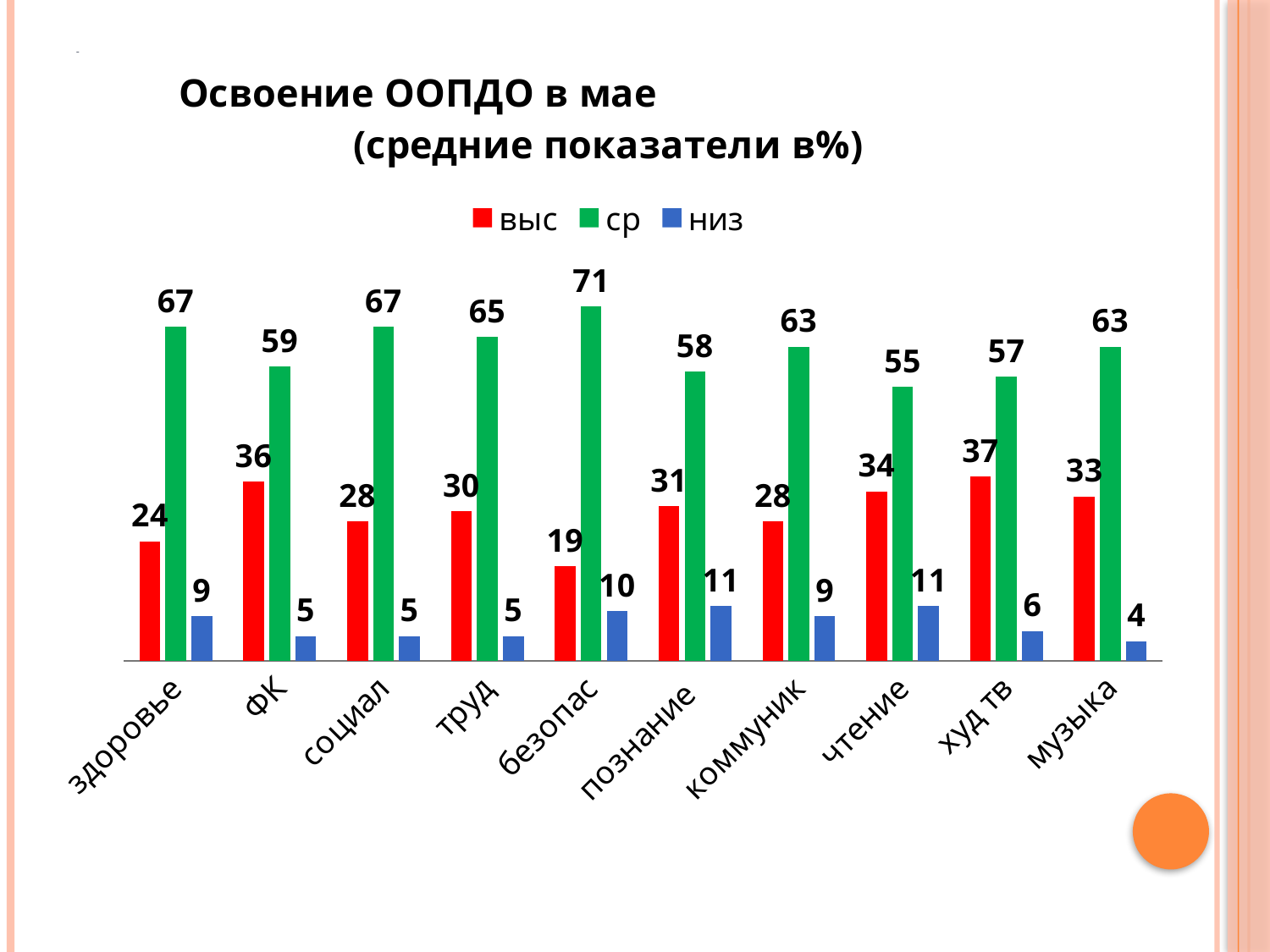
Which category has the highest value in the "ср" series? безопас How many categories are shown on the x axis? 10 What kind of chart is shown on the slide? bar chart Which category has the lowest value in the "низ" series? музыка What is the value of the "низ" series for "познание"? 11 Which colour represents the "ср" series in the legend? green What is the difference between the "ср" and "выс" values for "ФК"? 23 What is the value of the "ср" series for "безопас"? 71 What is the value of the "выс" series for "здоровье"? 24 Which is larger: the "выс" value for "худ тв" or the "выс" value for "чтение"? худ тв How many series does the legend list? 3 Which category has the lowest value in the "выс" series? безопас